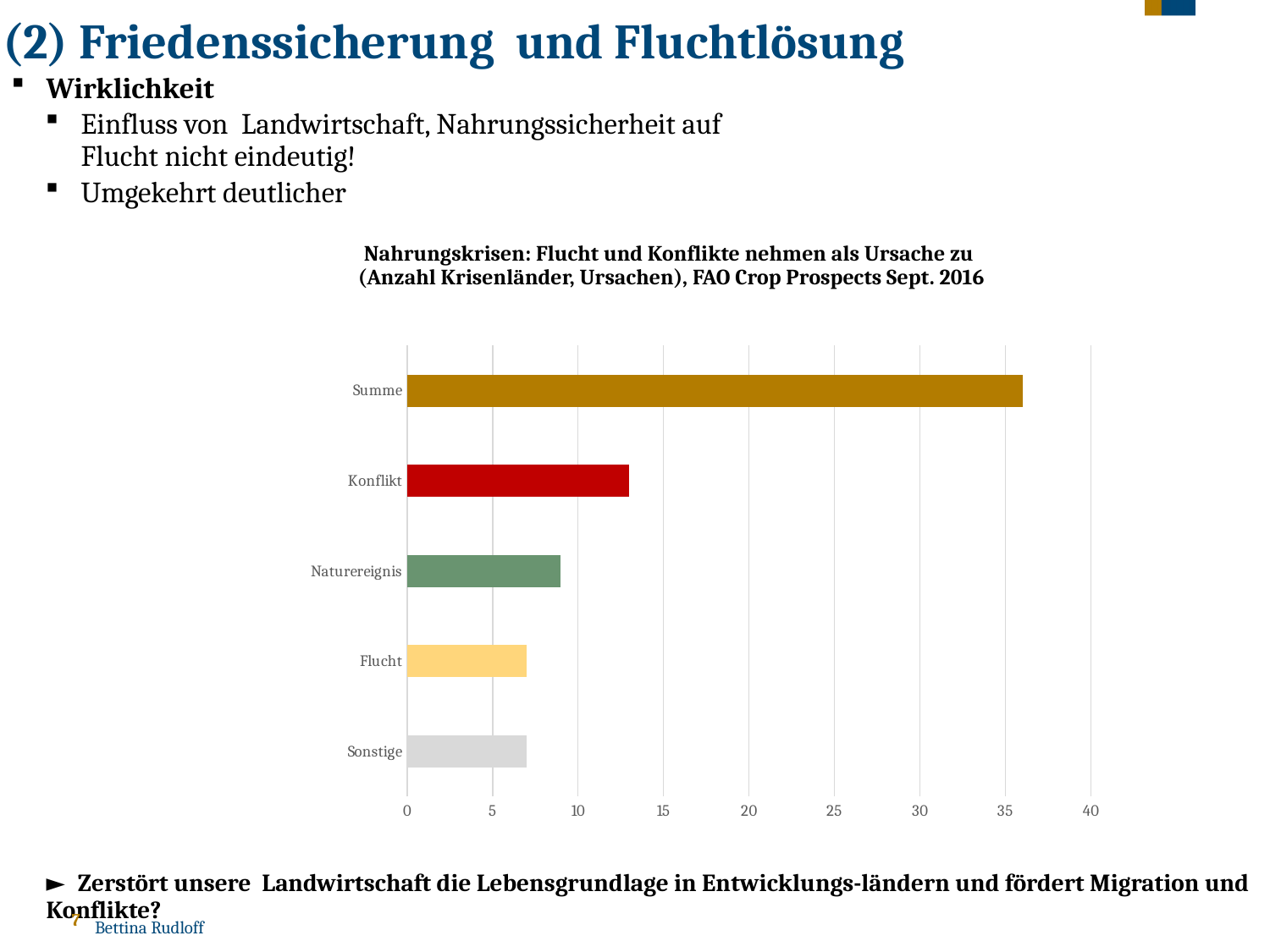
Which is larger, the value for Naturereignis or the value for Flucht? Naturereignis Is the value for Flucht greater or less than 5? greater Is the value for Sonstige greater or less than 10? less Is the value for Summe greater or less than 30? greater Which category has the highest value in the chart? Summe Which is larger, the value for Konflikt or the value for Naturereignis? Konflikt How many categories are shown on the chart? 5 What kind of chart is shown on the slide? bar chart What is the source cited in the chart title? FAO Crop Prospects Sept. 2016